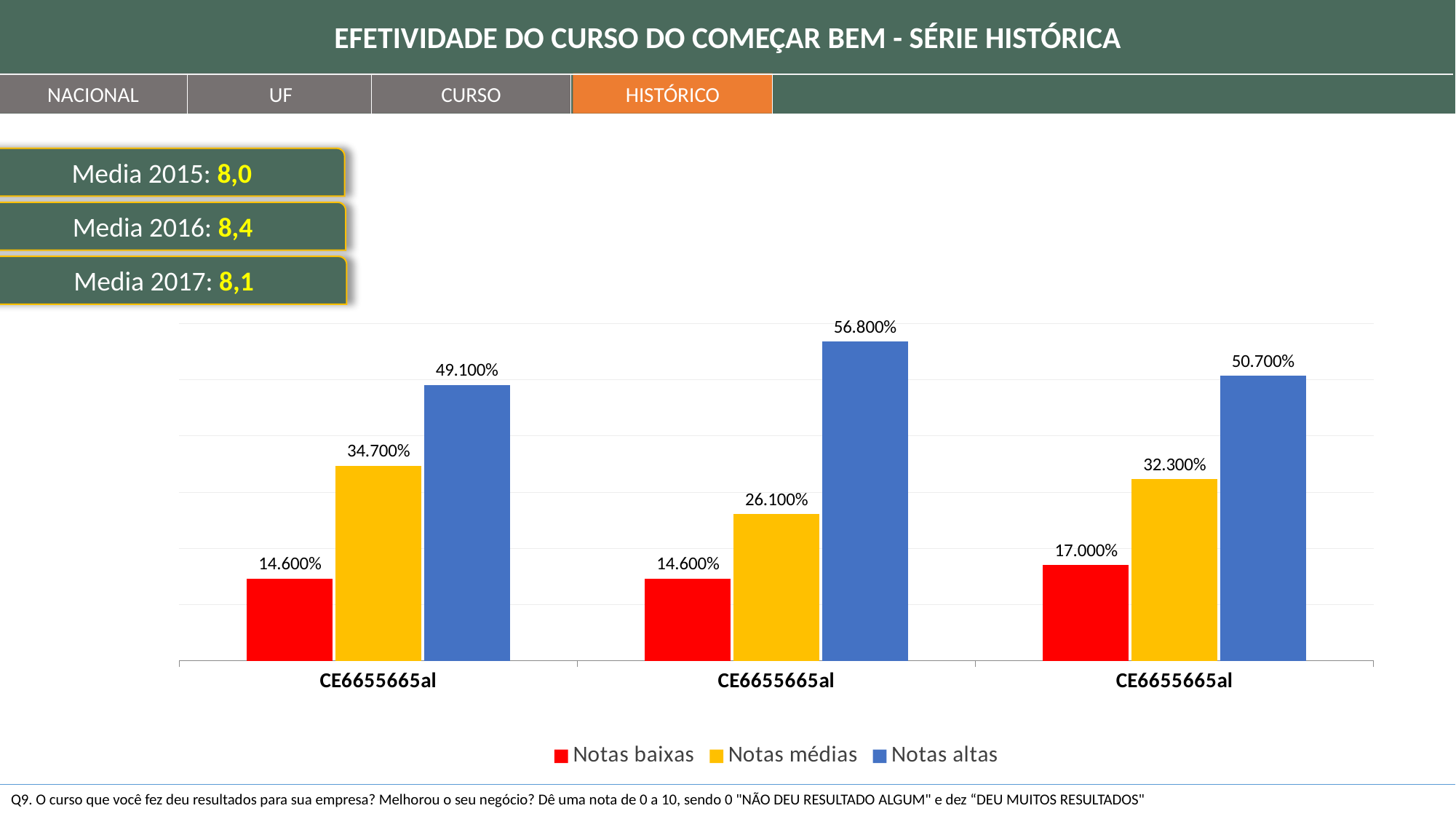
Which colour represents Notas baixas in the legend? Red What is the value of Notas altas for the left-most group of bars? 49.100% What is the value of Notas baixas for the right-most group of bars? 17.000% Which group of bars has the lowest Notas médias value? The middle group (26.100%) How many groups of bars are shown on the x axis? 3 What is the difference between Notas altas and Notas baixas in the middle group of bars? 42.200% How many series does the legend list? 3 What is the value of Notas médias for the middle group of bars? 26.100% In the right-most group, which is larger: Notas médias or Notas altas? Notas altas What kind of chart is shown on the slide? Bar chart Which group of bars has the highest Notas altas value? The middle group (56.800%) What is the total of the three bars in the left-most group? 98.400%